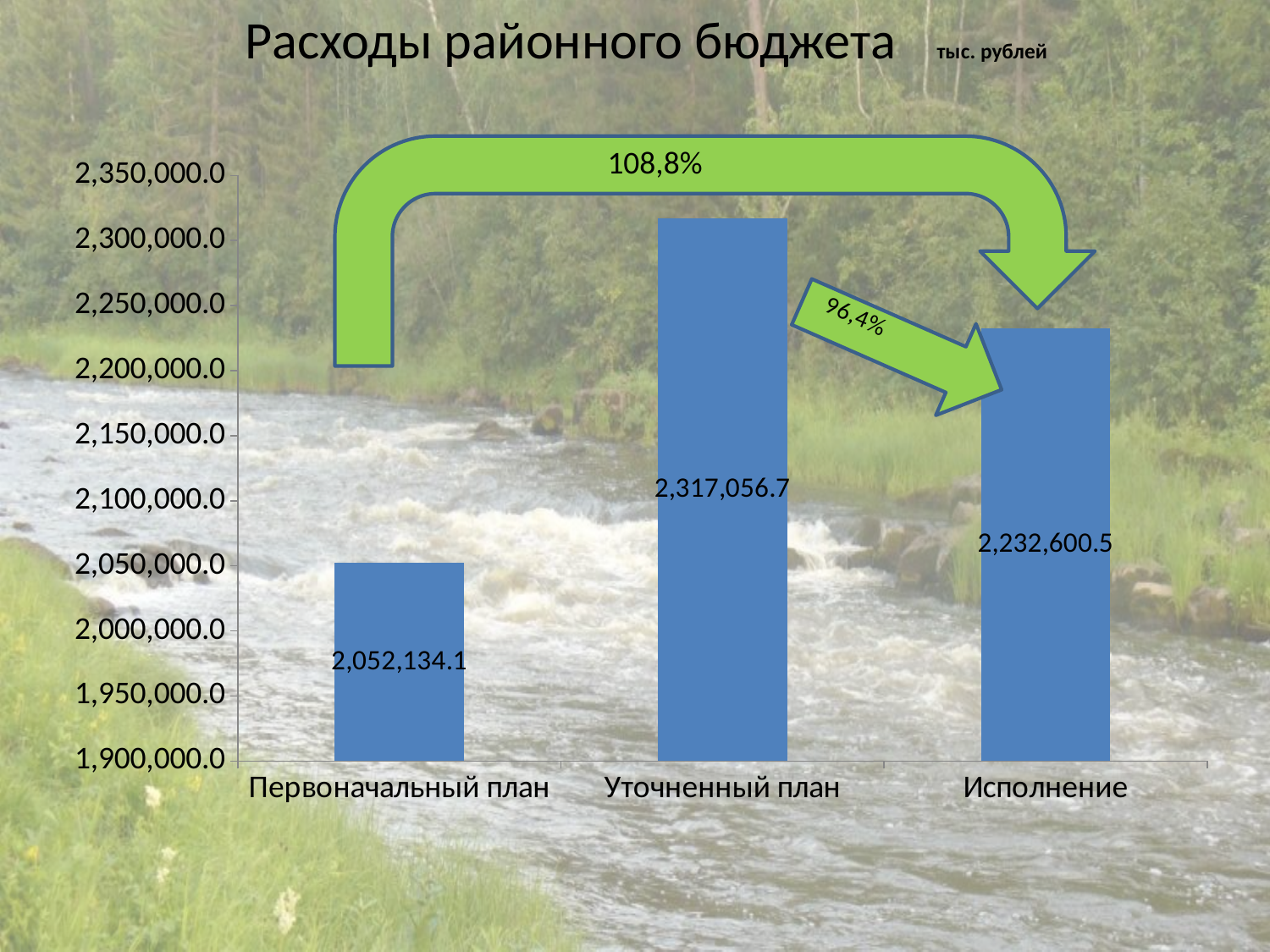
Which category has the lowest value? Первоначальный план What kind of chart is shown on the slide? bar chart Is the value for Исполнение greater or less than 2,200,000.0? greater What is the difference between Уточненный план and Первоначальный план? 264,922.6 How many categories are shown in the chart? 3 What is the title of the chart? Расходы районного бюджета What is the difference between Уточненный план and Исполнение? 84,456.2 What is the value for Исполнение? 2,232,600.5 Which is larger, Исполнение or Первоначальный план? Исполнение What is the value for Уточненный план? 2,317,056.7 Which category has the highest value? Уточненный план What is the value for Первоначальный план? 2,052,134.1